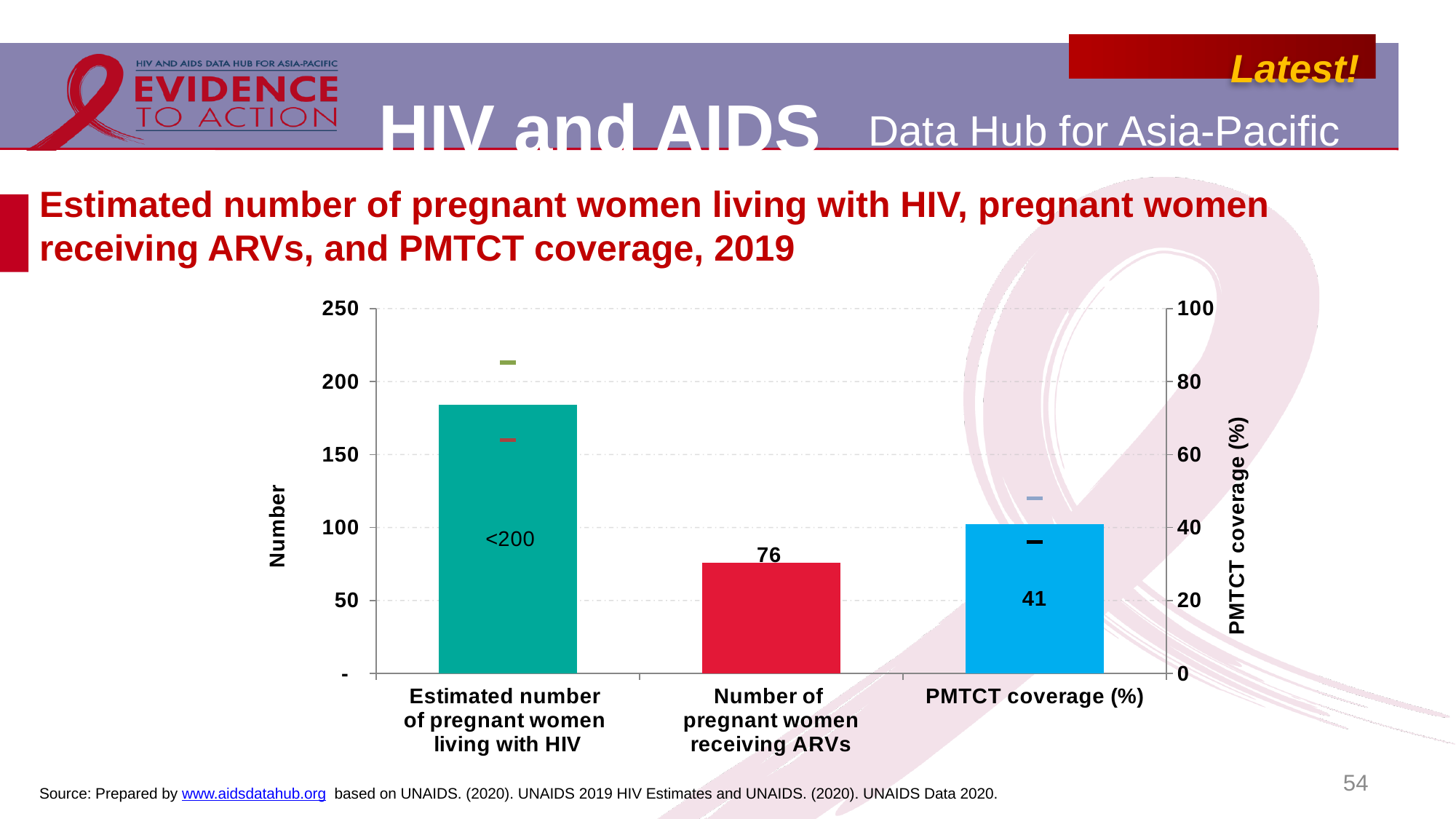
What is the data label on the bar for Estimated number of pregnant women living with HIV? <200 Which category has the shortest bar? Number of pregnant women receiving ARVs What type of chart is shown on the slide? Bar chart What is the data label on the bar for Number of pregnant women receiving ARVs? 76 Which category has the tallest bar? Estimated number of pregnant women living with HIV What is the label of the left vertical axis? Number What is the data label on the bar for PMTCT coverage (%)? 41 How many bars are shown in the chart? 3 Is the bar for Estimated number of pregnant women living with HIV greater or less than 150 on the left axis? greater Is the bar for Number of pregnant women receiving ARVs greater or less than 100 on the left axis? less What is the label of the right vertical axis? PMTCT coverage (%) Is the bar for PMTCT coverage (%) greater or less than 60 on the right axis? less